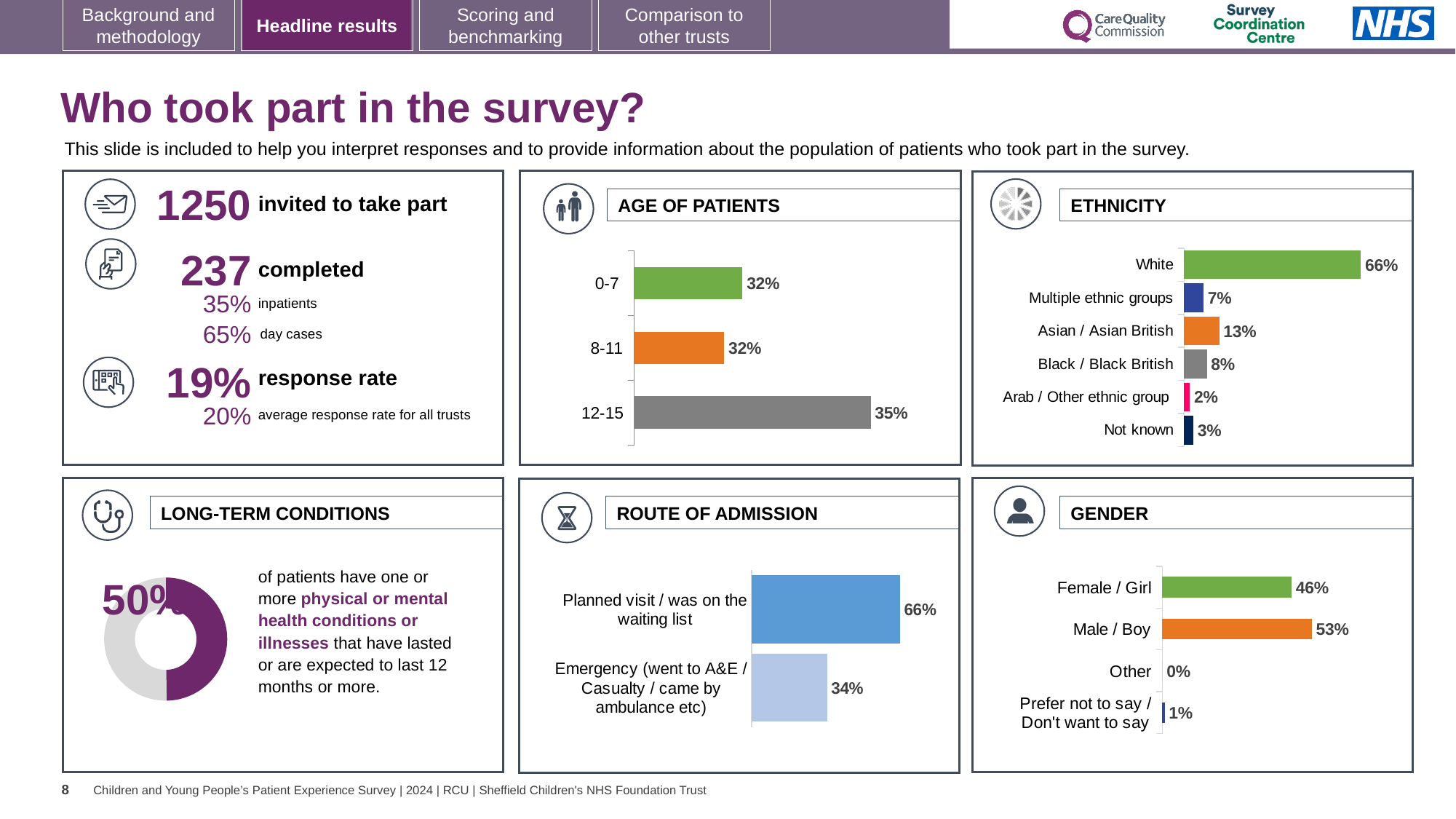
In the ETHNICITY chart, what is the value for Asian / Asian British? 13% In the LONG-TERM CONDITIONS chart, what percentage of patients have one or more physical or mental health conditions or illnesses? 50% In the GENDER chart, what is the difference between the values for Male / Boy and Female / Girl? 7% In the ETHNICITY chart, what is the difference between the values for White and Black / Black British? 58% In the ROUTE OF ADMISSION chart, which route has the larger value, Planned visit / was on the waiting list or Emergency? Planned visit / was on the waiting list In the ETHNICITY chart, which category has the lowest value? Arab / Other ethnic group In the AGE OF PATIENTS chart, which age group has the highest value? 12-15 In the AGE OF PATIENTS chart, what is the value for the 12-15 age group? 35% What kind of chart is the LONG-TERM CONDITIONS chart? Doughnut chart In the GENDER chart, what is the value for Male / Boy? 53% In the ROUTE OF ADMISSION chart, what is the value for Emergency (went to A&E / Casualty / came by ambulance etc)? 34% How many categories are shown in the ETHNICITY chart? 6